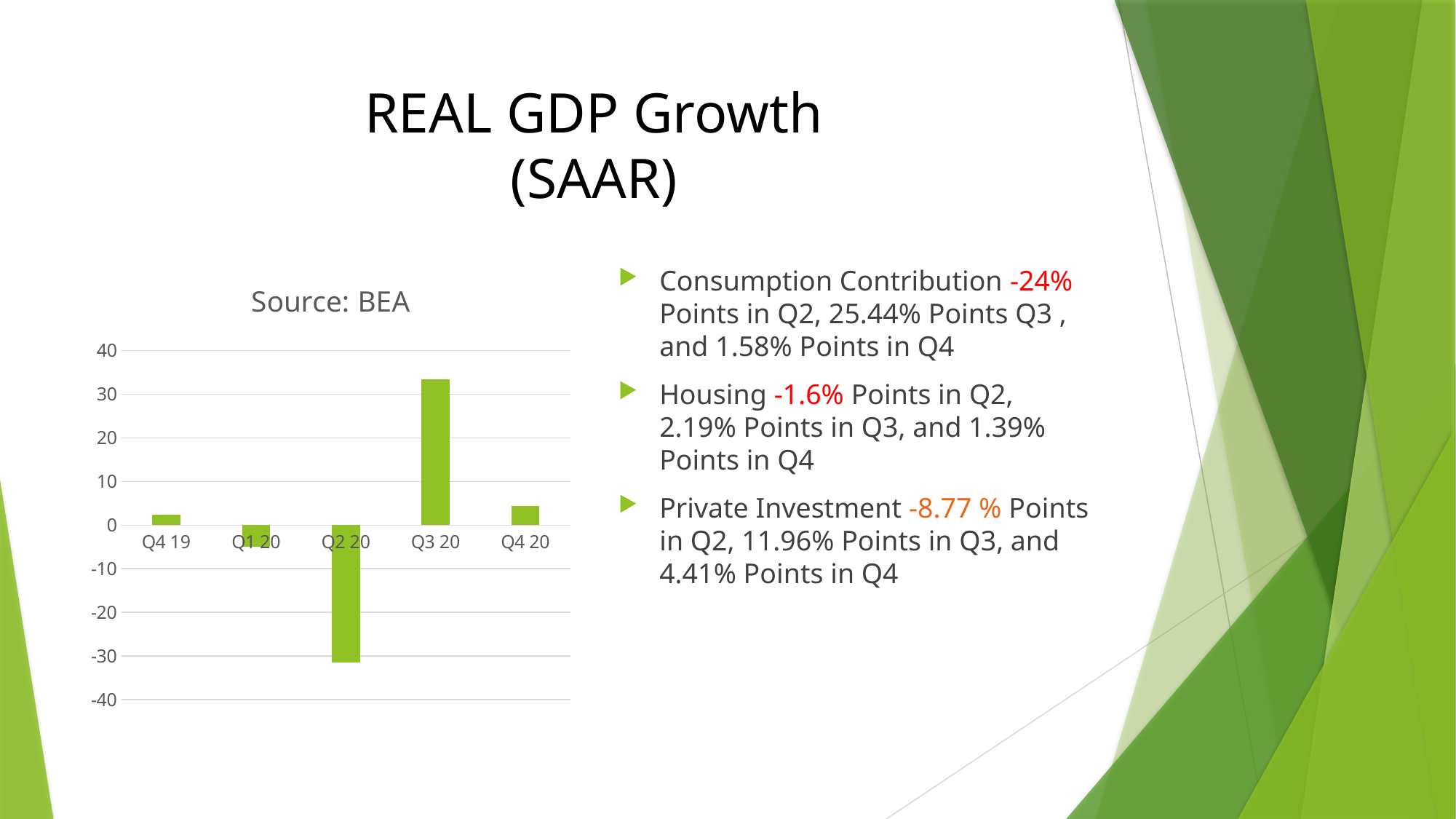
Which is larger, the value for Q4 19 or the value for Q1 20? Q4 19 What is the title shown above the chart? Source: BEA What kind of chart is shown on the slide? bar chart Is the value for Q2 20 greater or less than -20? less Which is larger, the value for Q3 20 or the value for Q4 20? Q3 20 Which quarter has the highest value on the chart? Q3 20 Which quarter has the lowest value on the chart? Q2 20 Do the values rise or fall from Q2 20 to Q3 20? rise Is the value for Q4 20 greater or less than 10? less Is the value for Q1 20 greater or less than 0? less How many quarters are plotted on the chart? 5